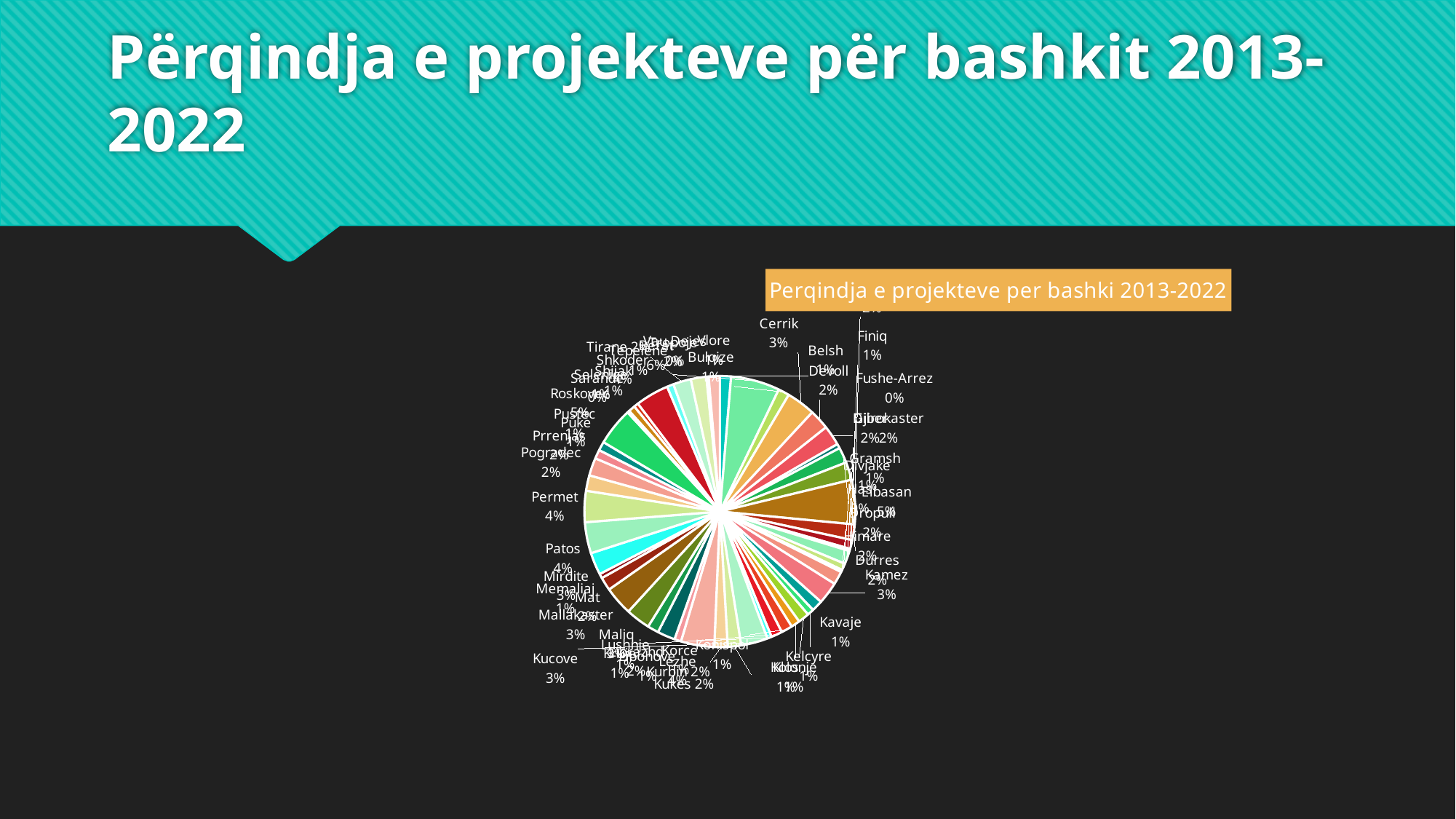
What is the difference between the shares of Elbasan and Cerrik in the pie chart? 2% What share of projects does Patos have in the pie chart? 4% What share of projects does Kucove have in the pie chart? 3% Which has a larger share in the pie chart, Elbasan or Kavaje? Elbasan What share of projects does Cerrik have in the pie chart? 3% What is the title of the chart on the slide? Perqindja e projekteve per bashki 2013-2022 What kind of chart is shown on the slide? pie chart